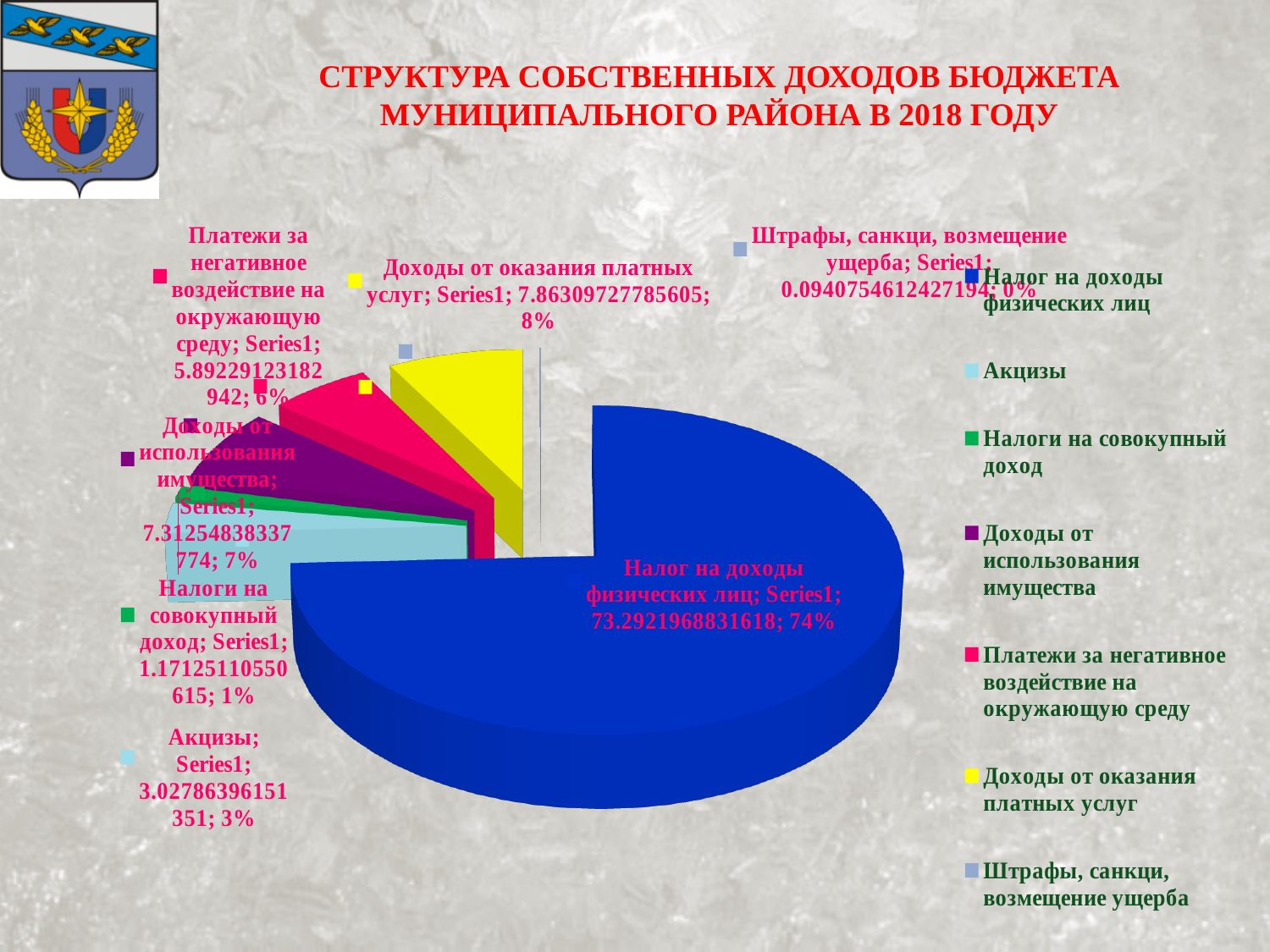
Which category has the largest share of the pie chart? Налог на доходы физических лиц What percentage share does "Платежи за негативное воздействие на окружающую среду" have in the pie chart? 6% What type of chart is shown on the slide? pie chart What percentage share does "Налог на доходы физических лиц" have in the pie chart? 74% What percentage share does "Доходы от оказания платных услуг" have in the pie chart? 8% Which category has the smallest share of the pie chart? Штрафы, санкци, возмещение ущерба How many categories does the legend of the pie chart list? 7 Which has a larger share: "Доходы от оказания платных услуг" or "Налоги на совокупный доход"? Доходы от оказания платных услуг What percentage share does "Акцизы" have in the pie chart? 3% What is the difference in percentage points between the share of "Налог на доходы физических лиц" and the share of "Доходы от оказания платных услуг"? 66% What percentage share does "Доходы от использования имущества" have in the pie chart? 7% What is the title of the chart on the slide? СТРУКТУРА СОБСТВЕННЫХ ДОХОДОВ БЮДЖЕТА МУНИЦИПАЛЬНОГО РАЙОНА В 2018 ГОДУ